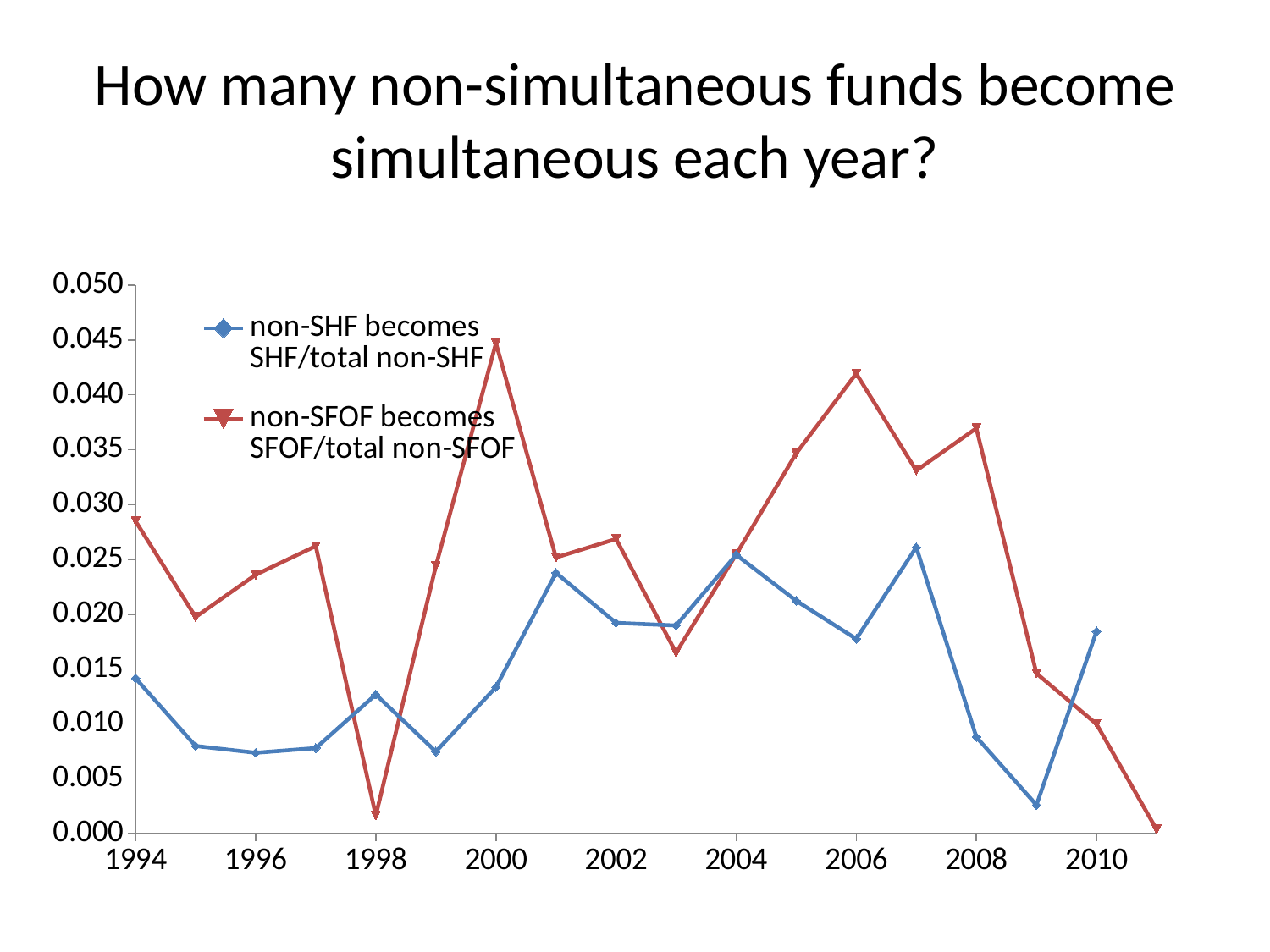
In which year does the non-SHF becomes SHF/total non-SHF series reach its lowest value? 2009 What kind of chart is shown on the slide? line chart In which year does the non-SFOF becomes SFOF/total non-SFOF series reach its highest value? 2000 In which year does the non-SFOF becomes SFOF/total non-SFOF series reach its lowest value? 2011 How many series does the legend list? 2 What is the title of the chart? How many non-simultaneous funds become simultaneous each year? Is the value for non-SFOF becomes SFOF/total non-SFOF in 2000 greater or less than 0.040? greater Is the value for non-SHF becomes SHF/total non-SHF in 2009 greater or less than 0.005? less In 1998, which series has the larger value: non-SHF becomes SHF/total non-SHF or non-SFOF becomes SFOF/total non-SFOF? non-SHF becomes SHF/total non-SHF Does the non-SFOF becomes SFOF/total non-SFOF series rise or fall from 2008 to 2011? fall Is the value for non-SFOF becomes SFOF/total non-SFOF in 1998 greater or less than 0.005? less Which series is drawn in red with triangle markers? non-SFOF becomes SFOF/total non-SFOF